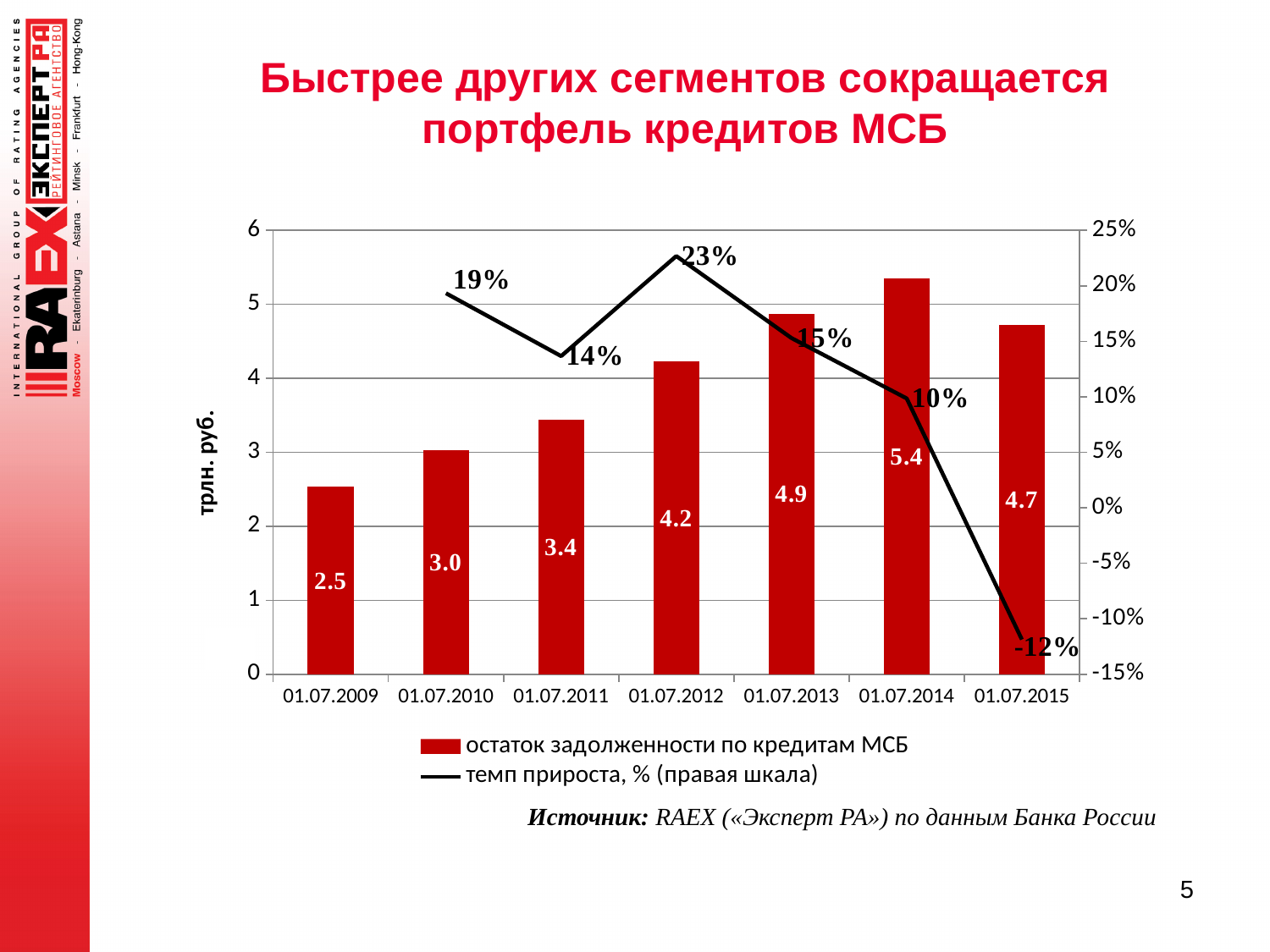
Which date has the highest остаток задолженности по кредитам МСБ? 01.07.2014 Is the остаток задолженности bar for 01.07.2013 greater or less than 4 on the left axis? greater Which is larger: the темп прироста for 01.07.2010 or for 01.07.2012? 01.07.2012 How many dates are shown on the x axis? 7 What is the value of остаток задолженности по кредитам МСБ for 01.07.2012? 4.2 Does the остаток задолженности по кредитам МСБ rise or fall from 01.07.2009 to 01.07.2014? rise Which date has the lowest темп прироста? 01.07.2015 What is the unit shown on the left vertical axis? трлн. руб. How many series does the legend list? 2 What is the темп прироста value for 01.07.2015? -12% What kind of chart is used for остаток задолженности по кредитам МСБ? bar chart What is the difference between the остаток задолженности values for 01.07.2014 and 01.07.2015? 0.7